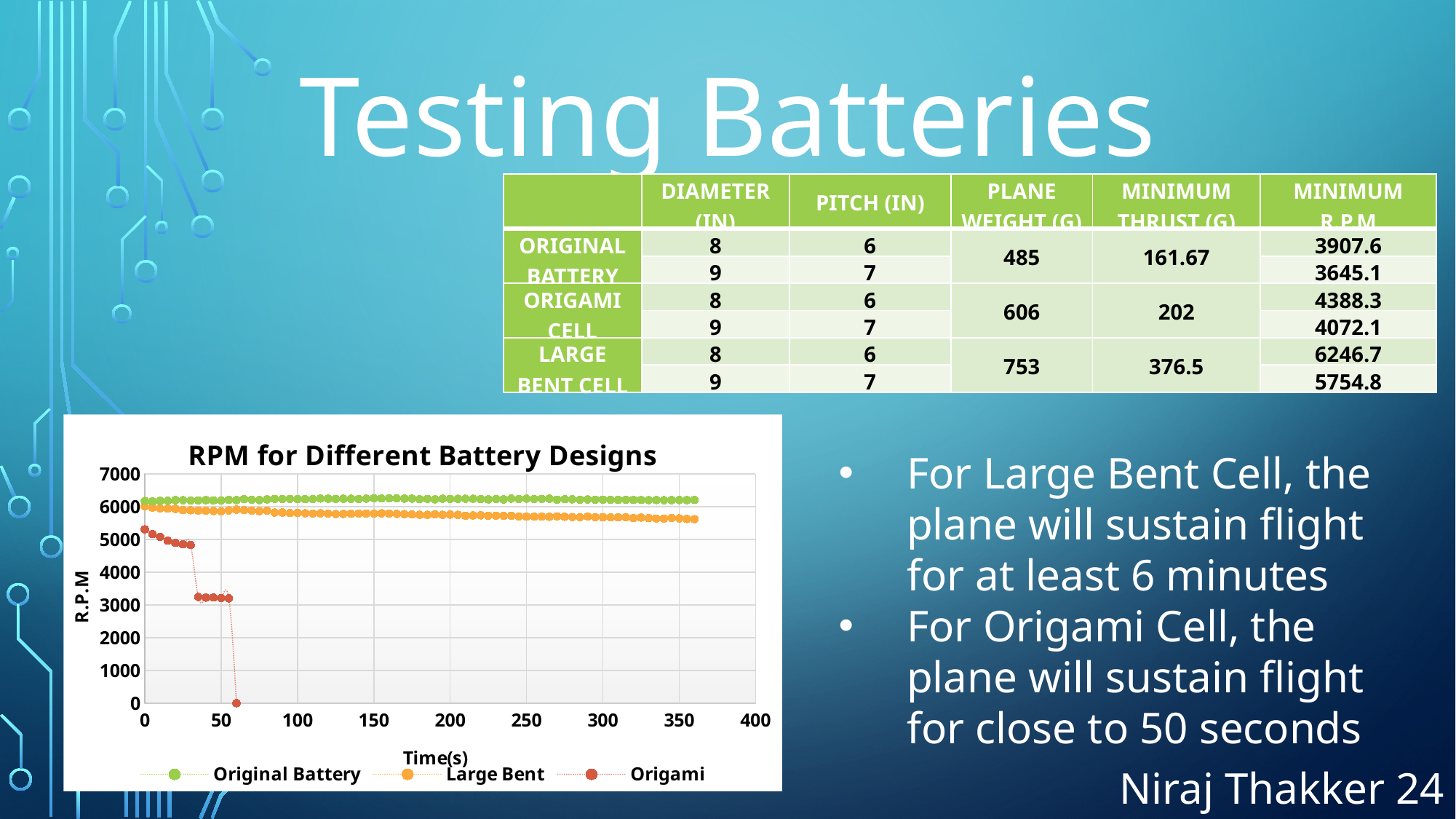
What kind of chart is shown on the slide? scatter chart Is the value for Large Bent at 300 seconds greater or less than 6000? less What is the title of the chart? RPM for Different Battery Designs Is the value for Origami at 0 seconds greater or less than 5000? greater At 200 seconds, which series has the higher RPM, Original Battery or Large Bent? Original Battery What is the label on the y axis of the chart? R.P.M Is the value for Original Battery at 100 seconds greater or less than 6000? greater Do the values for the Origami series rise or fall as time increases? fall How many series does the chart legend list? 3 Which series has the lowest RPM values on the chart? Origami Do the values for the Large Bent series rise or fall as time increases? fall